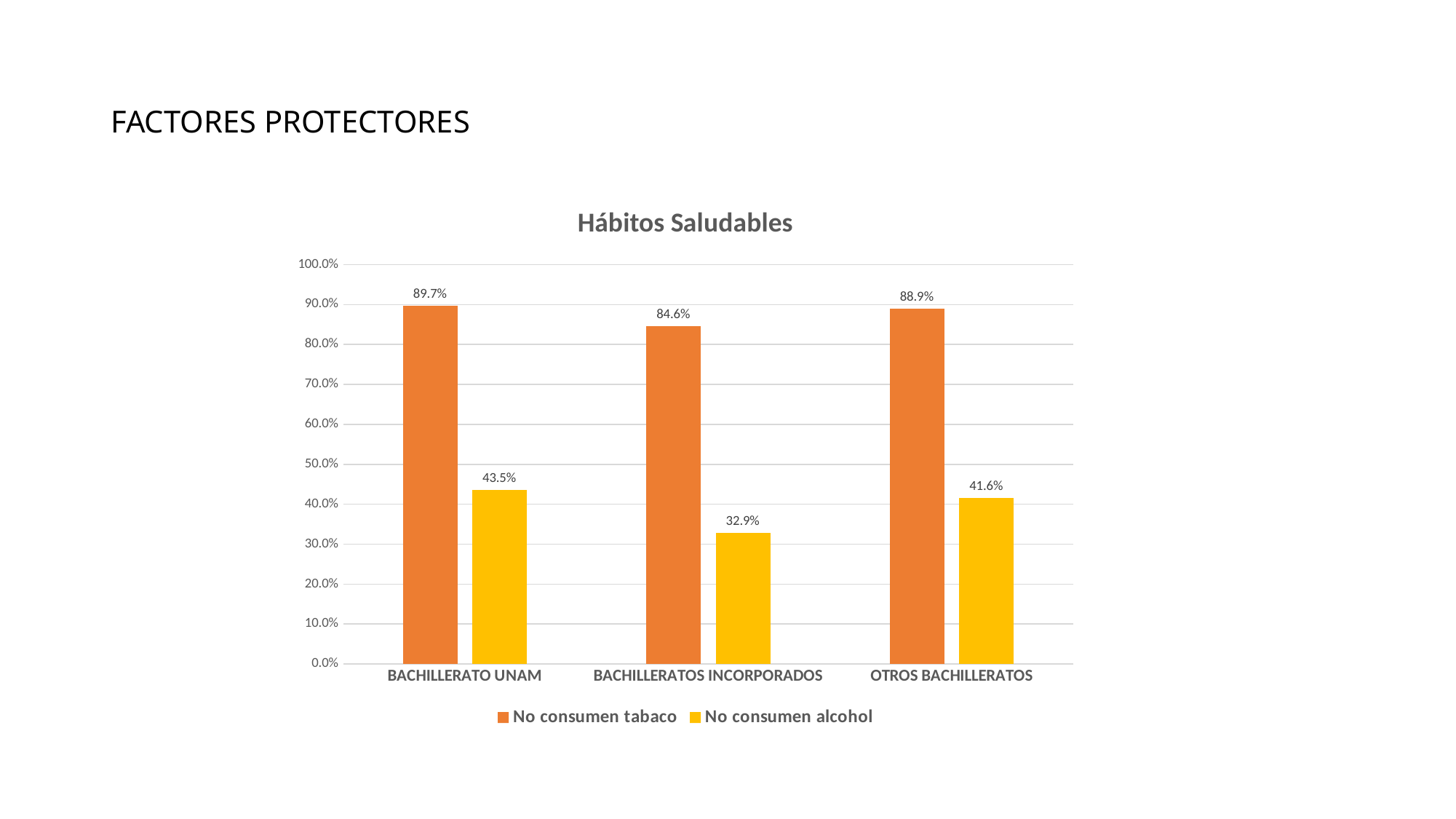
How many series does the legend list? 2 Which category has the highest value for 'No consumen tabaco'? BACHILLERATO UNAM What is the value for 'No consumen alcohol' for BACHILLERATOS INCORPORADOS? 32.9% How many categories are shown on the x axis? 3 What is the difference between the 'No consumen alcohol' values for BACHILLERATO UNAM and OTROS BACHILLERATOS? 1.9% What is the difference between 'No consumen tabaco' and 'No consumen alcohol' for BACHILLERATO UNAM? 46.2% What type of chart is shown on the slide? bar chart What is the value for 'No consumen tabaco' for BACHILLERATO UNAM? 89.7% What is the value for 'No consumen alcohol' for OTROS BACHILLERATOS? 41.6% Which is larger: 'No consumen tabaco' for BACHILLERATOS INCORPORADOS or for OTROS BACHILLERATOS? OTROS BACHILLERATOS Is the value for 'No consumen alcohol' for BACHILLERATO UNAM greater or less than 50.0%? less Which category has the lowest value for 'No consumen alcohol'? BACHILLERATOS INCORPORADOS